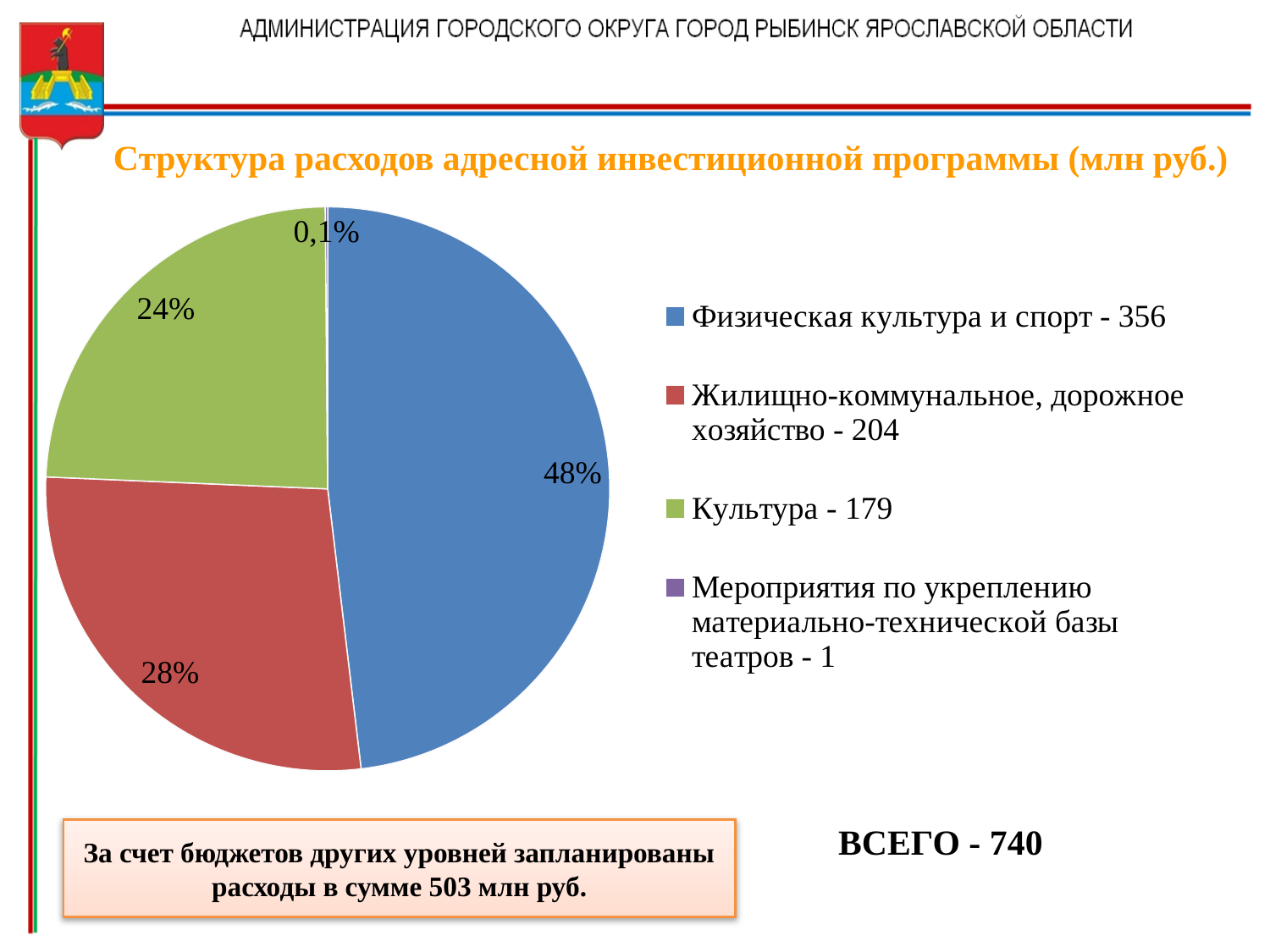
What kind of chart is shown on the slide? pie chart What share of the pie does "Физическая культура и спорт" take? 48% Which category has the smallest slice of the pie? Мероприятия по укреплению материально-технической базы театров What share of the pie does "Жилищно-коммунальное, дорожное хозяйство" take? 28% What is the difference in million rubles between "Физическая культура и спорт" and "Культура"? 177 What share of the pie does "Мероприятия по укреплению материально-технической базы театров" take? 0,1% How many slices does the pie chart have? 4 What is the title of the chart? Структура расходов адресной инвестиционной программы (млн руб.) What value (in million rubles) is given in the legend for "Культура"? 179 What value (in million rubles) is given in the legend for "Жилищно-коммунальное, дорожное хозяйство"? 204 Which category has the largest slice of the pie? Физическая культура и спорт